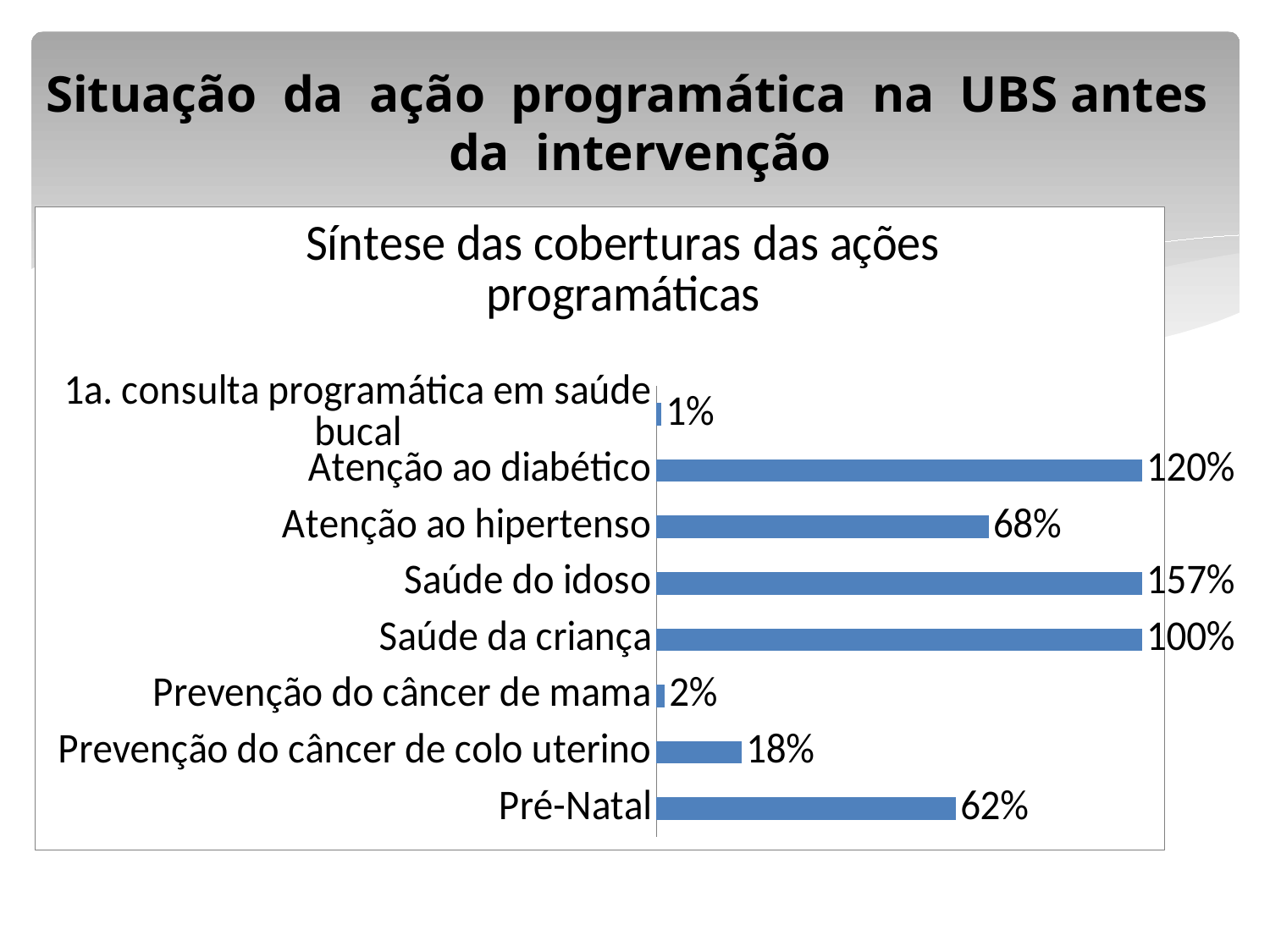
Which is larger, the value for Atenção ao hipertenso or the value for Pré-Natal? Atenção ao hipertenso What is the value for Prevenção do câncer de colo uterino? 18% What is the value for Saúde da criança? 100% Which category has the lowest value? 1a. consulta programática em saúde bucal What kind of chart is shown on the slide? Bar chart Which category has the highest value? Saúde do idoso What is the value for Pré-Natal? 62% What is the difference between the values for Saúde do idoso and Atenção ao diabético? 37% What is the difference between the values for Prevenção do câncer de colo uterino and Prevenção do câncer de mama? 16% What is the value for Atenção ao hipertenso? 68% What is the title of the chart? Síntese das coberturas das ações programáticas How many categories are shown in the chart? 8